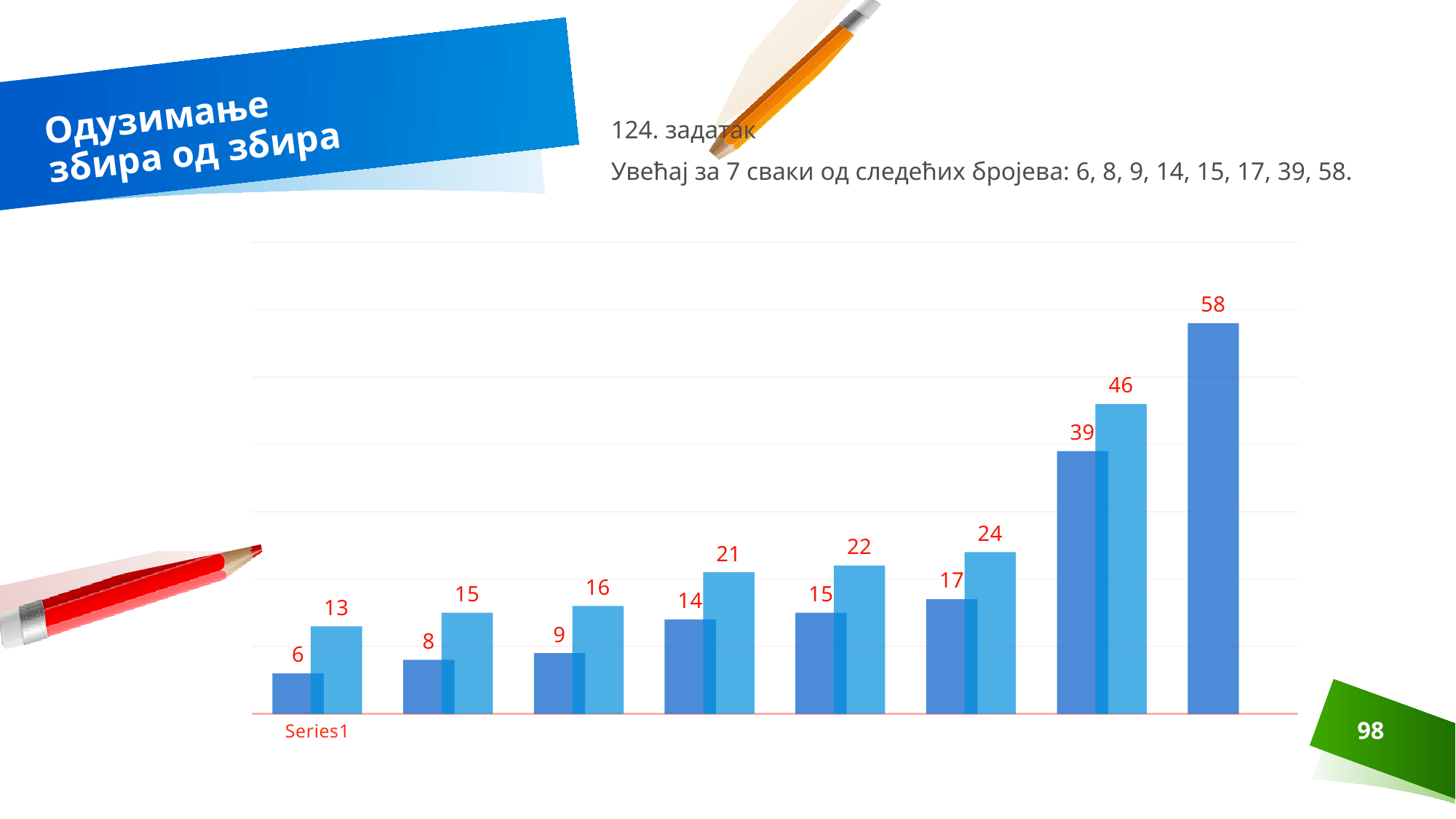
What is the highest value labelled on any bar in the chart? 58 How many groups of bars are plotted along the x axis? 8 What category label is printed under the first group of bars? Series1 What is the value of the lighter blue bar that stands next to the bar labelled 39? 46 Do the values of the darker blue bars rise or fall from left to right along the x axis? rise What is the difference between the lighter bar labelled 13 and the darker bar labelled 6 in the first group? 7 What is the value of the lighter blue bar that stands next to the bar labelled 17? 24 What kind of chart is shown on the slide? bar chart What is the difference between the bar labelled 58 and the bar labelled 46? 12 What is the lowest value labelled on any bar in the chart? 6 Which is larger: the bar labelled 39 or the lighter bar beside it labelled 46? 46 What is the value of the lighter blue bar that stands next to the bar labelled 9? 16